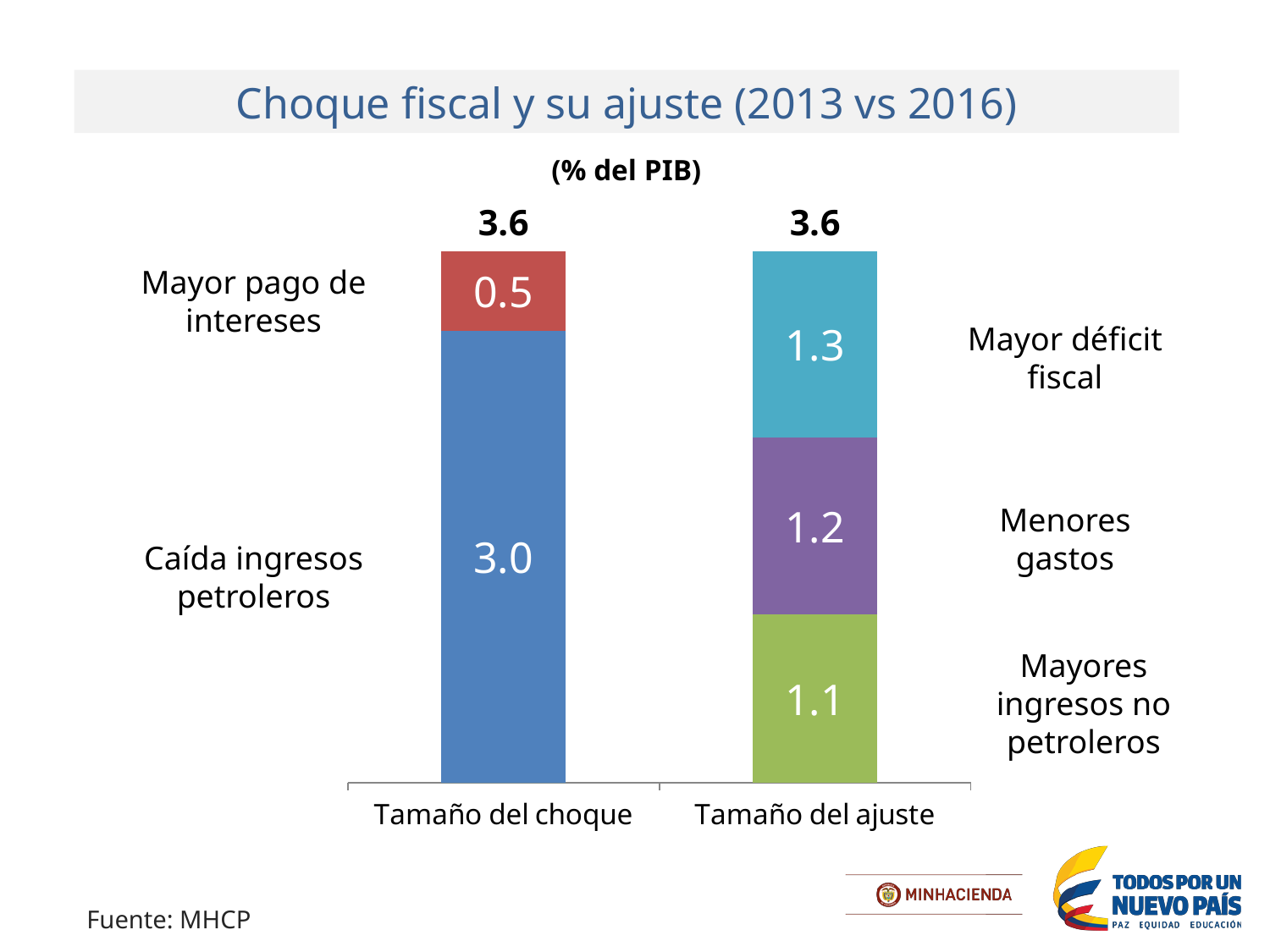
What is the total of the 'Tamaño del choque' stacked bar? 3.6 What is the total of the 'Tamaño del ajuste' stacked bar? 3.6 What is the difference between the 'Caída ingresos petroleros' segment and the 'Mayor pago de intereses' segment? 2.5 What type of chart is shown on the slide? Stacked bar chart What is the value of the 'Mayores ingresos no petroleros' segment? 1.1 Which segment of the 'Tamaño del ajuste' bar is the largest? Mayor déficit fiscal What is the value of the 'Mayor pago de intereses' segment? 0.5 What is the value of the 'Caída ingresos petroleros' segment in the 'Tamaño del choque' bar? 3.0 Which is larger, the 'Menores gastos' segment or the 'Mayores ingresos no petroleros' segment? Menores gastos What is the value of the 'Mayor déficit fiscal' segment in the 'Tamaño del ajuste' bar? 1.3 How many bars are shown on the x axis of the chart? 2 What is the value of the 'Menores gastos' segment? 1.2